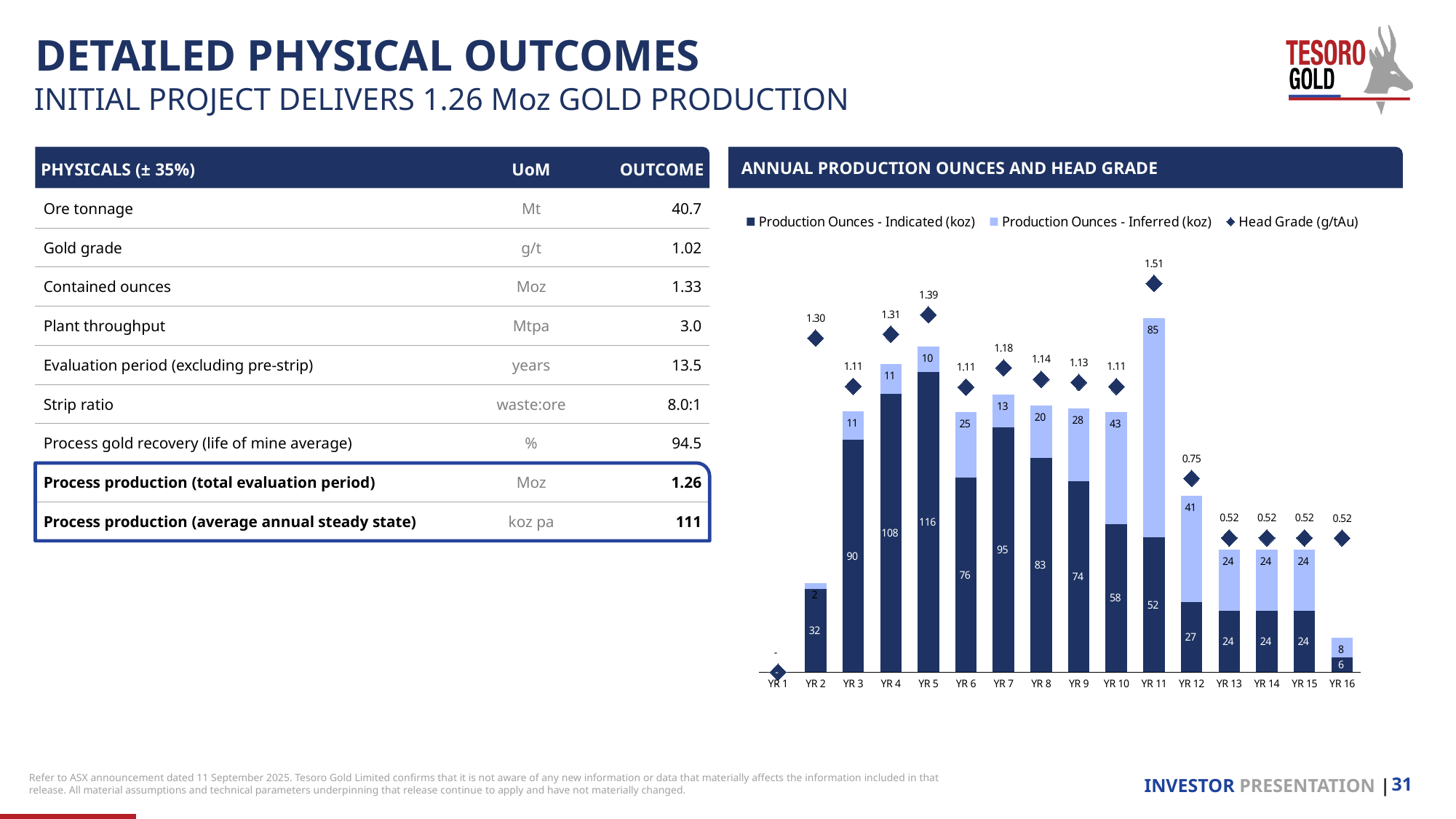
What is the Production Ounces - Indicated (koz) value for YR 5? 116 For YR 10, which is larger: Production Ounces - Indicated or Production Ounces - Inferred? Production Ounces - Indicated What is the title of the chart on the slide? ANNUAL PRODUCTION OUNCES AND HEAD GRADE How many year categories are shown on the x axis of the chart? 16 What is the difference between the Production Ounces - Indicated values for YR 5 and YR 4? 8 How many series does the chart legend list? 3 What is the Production Ounces - Inferred (koz) value for YR 11? 85 Does the Production Ounces - Indicated (koz) value rise or fall from YR 5 to YR 16? fall What is the Head Grade (g/tAu) value for YR 12? 0.75 What is the total production ounces (Indicated plus Inferred) for YR 11? 137 In which year is the Head Grade (g/tAu) highest? YR 11 In which year is the Production Ounces - Indicated (koz) value highest? YR 5